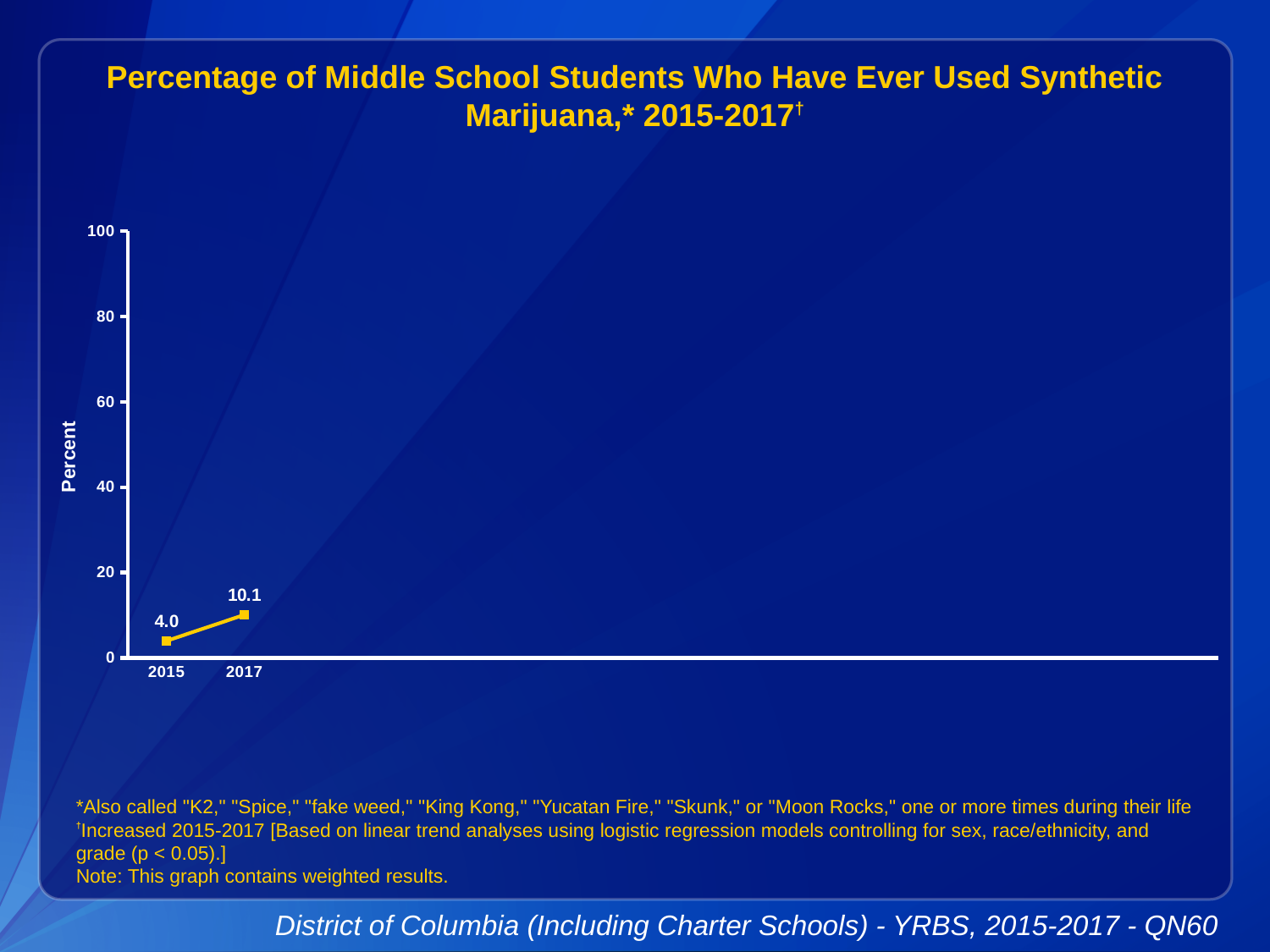
Which is larger, the value for 2015 or the value for 2017? 2017 What kind of chart is shown on the slide? line chart How many data points are plotted on the chart? 2 Is the value for 2017 greater or less than 20? less What is the label on the y axis? Percent Which year has the lowest value? 2015 Which year has the highest value? 2017 Do the values rise or fall from 2015 to 2017? rise What is the value for 2015? 4.0 What is the difference between the values for 2017 and 2015? 6.1 What is the maximum value shown on the y axis? 100 What is the value for 2017? 10.1